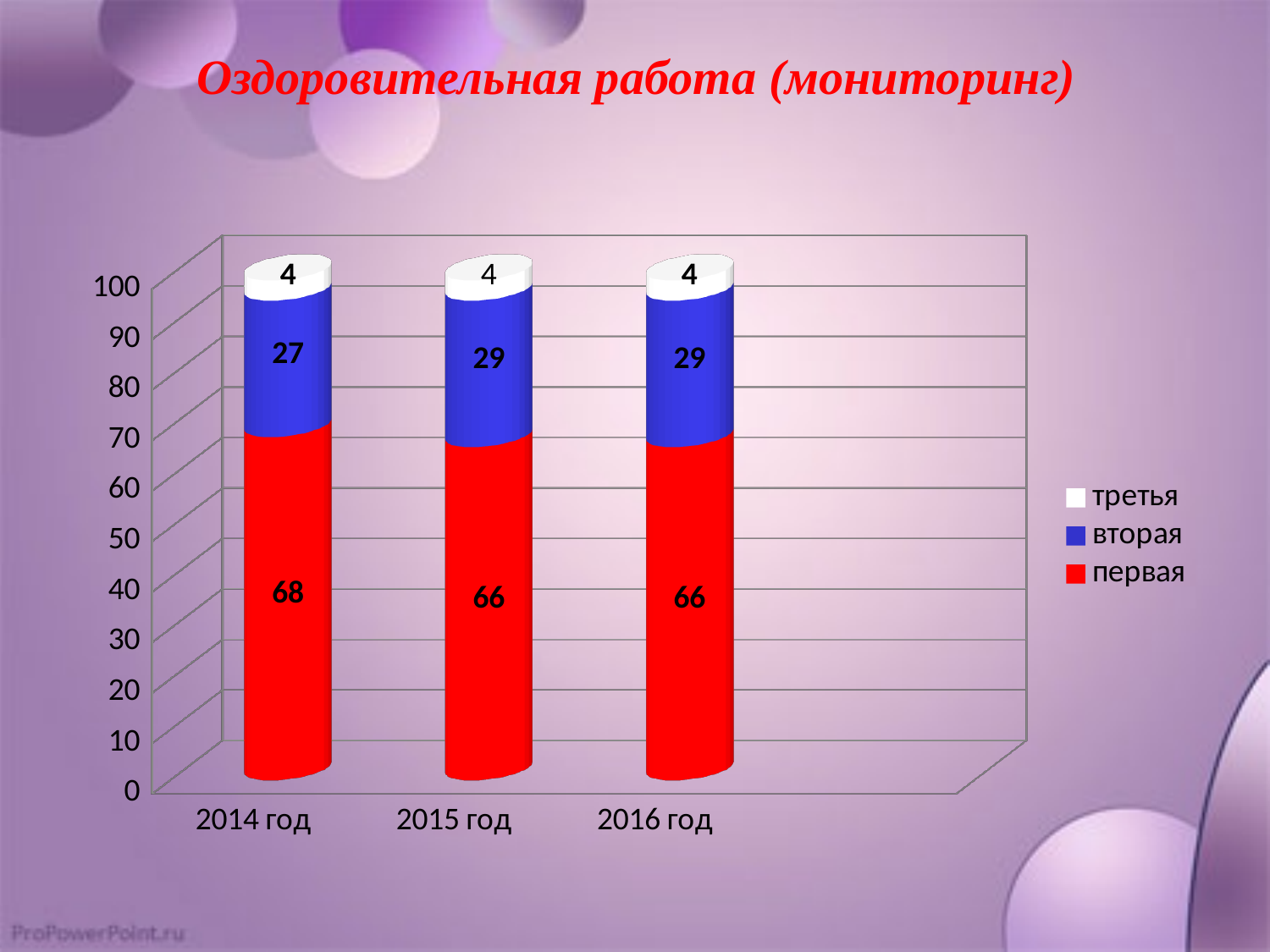
What is the value of the 'вторая' series for 2015 год? 29 How many series does the legend list? 3 What is the value of the 'вторая' series for 2014 год? 27 What is the difference between the 'первая' value for 2014 год and for 2015 год? 2 What kind of chart is shown on the slide? Stacked bar chart What is the value of the 'первая' series for 2014 год? 68 Which year has the highest value for the 'первая' series? 2014 год Which is larger: the 'вторая' value for 2014 год or for 2016 год? 2016 год What is the total of the stacked bar for 2015 год? 99 How many years are shown on the x axis? 3 Which year has the lowest value for the 'вторая' series? 2014 год What is the value of the 'третья' series for 2016 год? 4